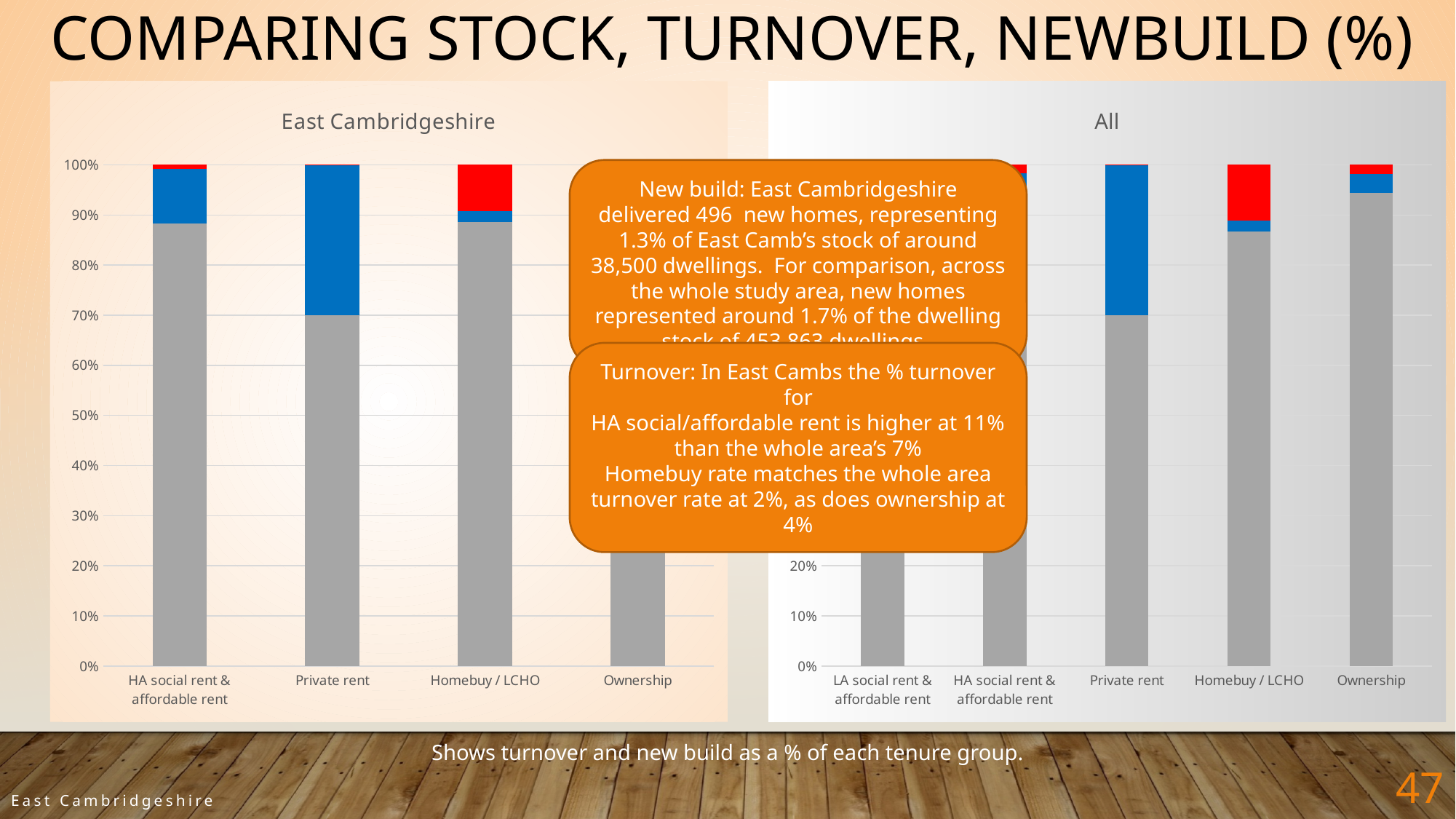
In the All chart, is the grey segment for Homebuy / LCHO greater or less than 80%? greater How many tenure categories are shown on the x axis of the East Cambridgeshire chart? 4 In the All chart, is the grey segment for Ownership greater or less than 90%? greater In the East Cambridgeshire chart, which has the larger grey segment: Private rent or HA social rent & affordable rent? HA social rent & affordable rent In the East Cambridgeshire chart, which has the larger red segment: Homebuy / LCHO or HA social rent & affordable rent? Homebuy / LCHO What kind of chart is the East Cambridgeshire chart? Stacked bar chart What is the highest value shown on the y axis of the East Cambridgeshire chart? 100% How many tenure categories are shown on the x axis of the All chart? 5 In the East Cambridgeshire chart, is the grey segment for HA social rent & affordable rent greater or less than 80%? greater What is the title of the chart on the right of the slide? All In the All chart, which has the larger blue segment: Private rent or Ownership? Private rent